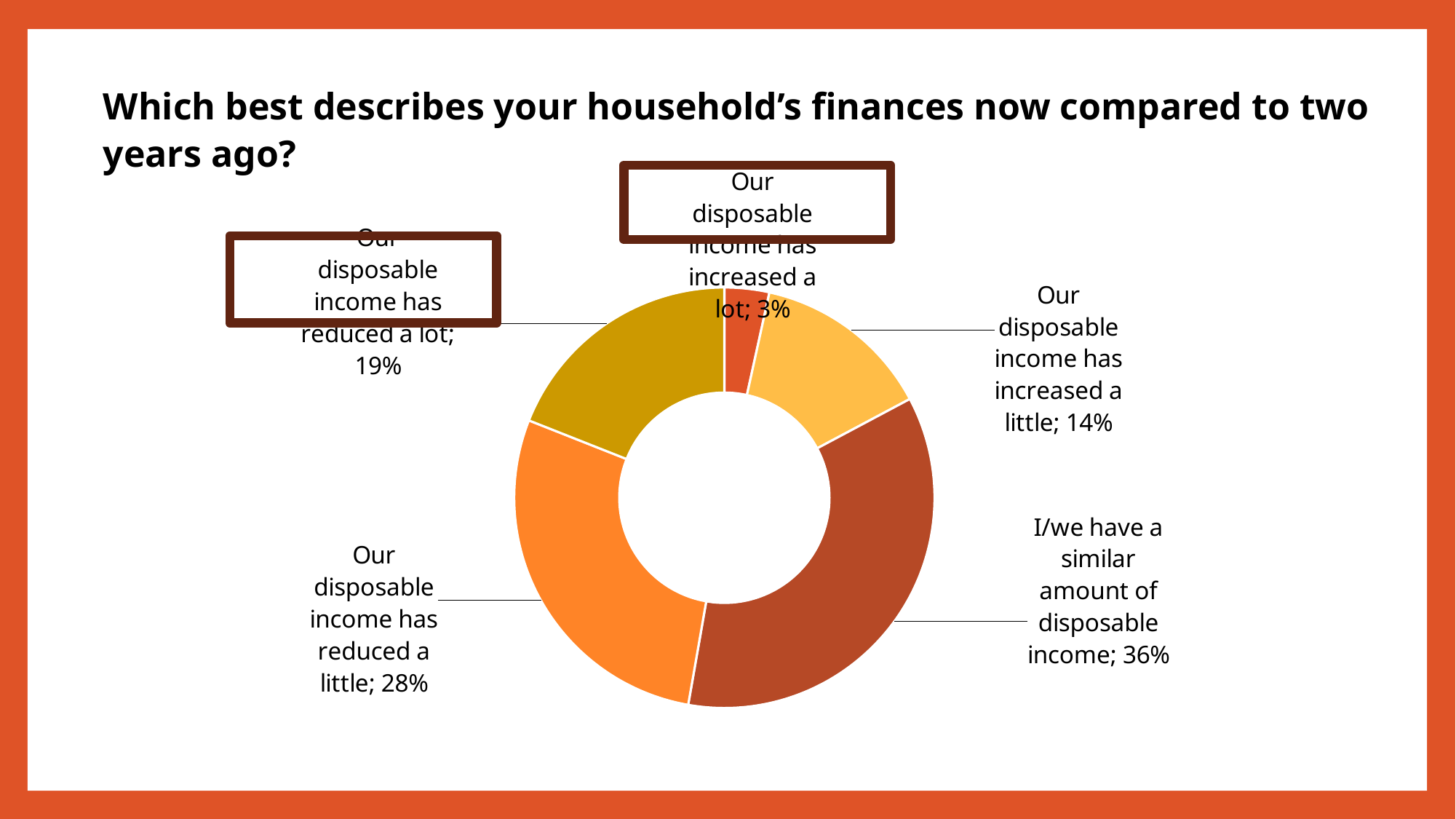
What percentage of respondents said they have a similar amount of disposable income? 36% How many response categories are shown in the chart? 5 What kind of chart is shown on the slide? Doughnut (pie) chart Which response has the smallest share of the chart? Our disposable income has increased a lot Which is larger: the share for 'increased a little' or the share for 'reduced a lot'? Our disposable income has reduced a lot What percentage of respondents said their disposable income has reduced a lot? 19% What percentage of respondents said their disposable income has increased a lot? 3% What percentage of respondents said their disposable income has increased a little? 14% What is the combined percentage of respondents whose disposable income has reduced (a little or a lot)? 47% What percentage of respondents said their disposable income has reduced a little? 28% Which response has the largest share of the chart? I/we have a similar amount of disposable income What is the difference in percentage points between 'reduced a little' and 'reduced a lot'? 9